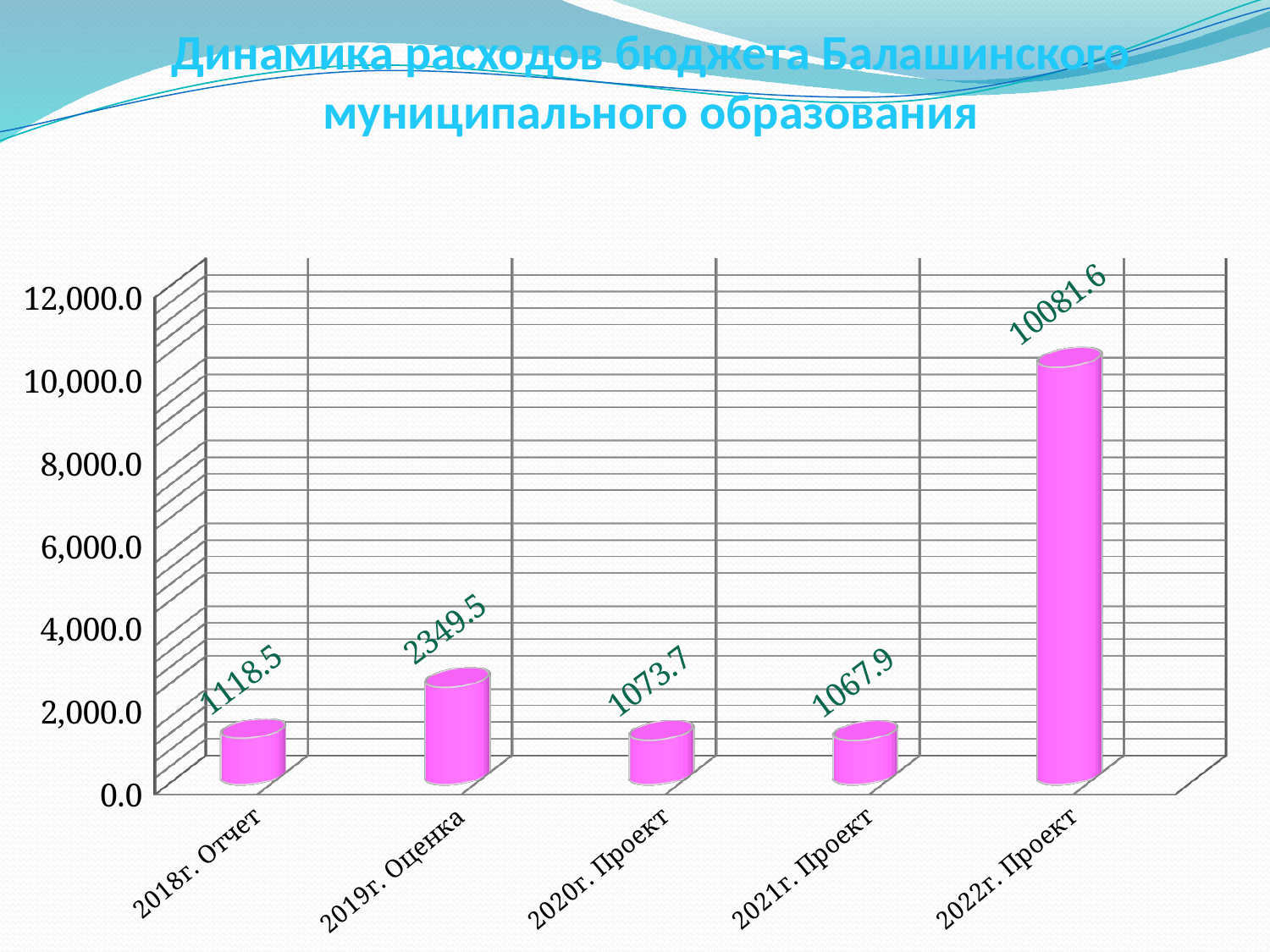
What is the difference between the values for 2022г. Проект and 2019г. Оценка? 7732.1 What kind of chart is shown on the slide? bar chart What is the value for 2022г. Проект? 10081.6 What is the value for 2019г. Оценка? 2349.5 What is the value for 2020г. Проект? 1073.7 Is the value for 2022г. Проект greater or less than 8,000.0? greater Which is larger, the value for 2019г. Оценка or the value for 2018г. Отчет? 2019г. Оценка What is the difference between the values for 2019г. Оценка and 2018г. Отчет? 1231.0 How many categories are shown on the x axis? 5 What is the value for 2018г. Отчет? 1118.5 Which category has the highest value? 2022г. Проект What is the title of the chart? Динамика расходов бюджета Балашинского муниципального образования